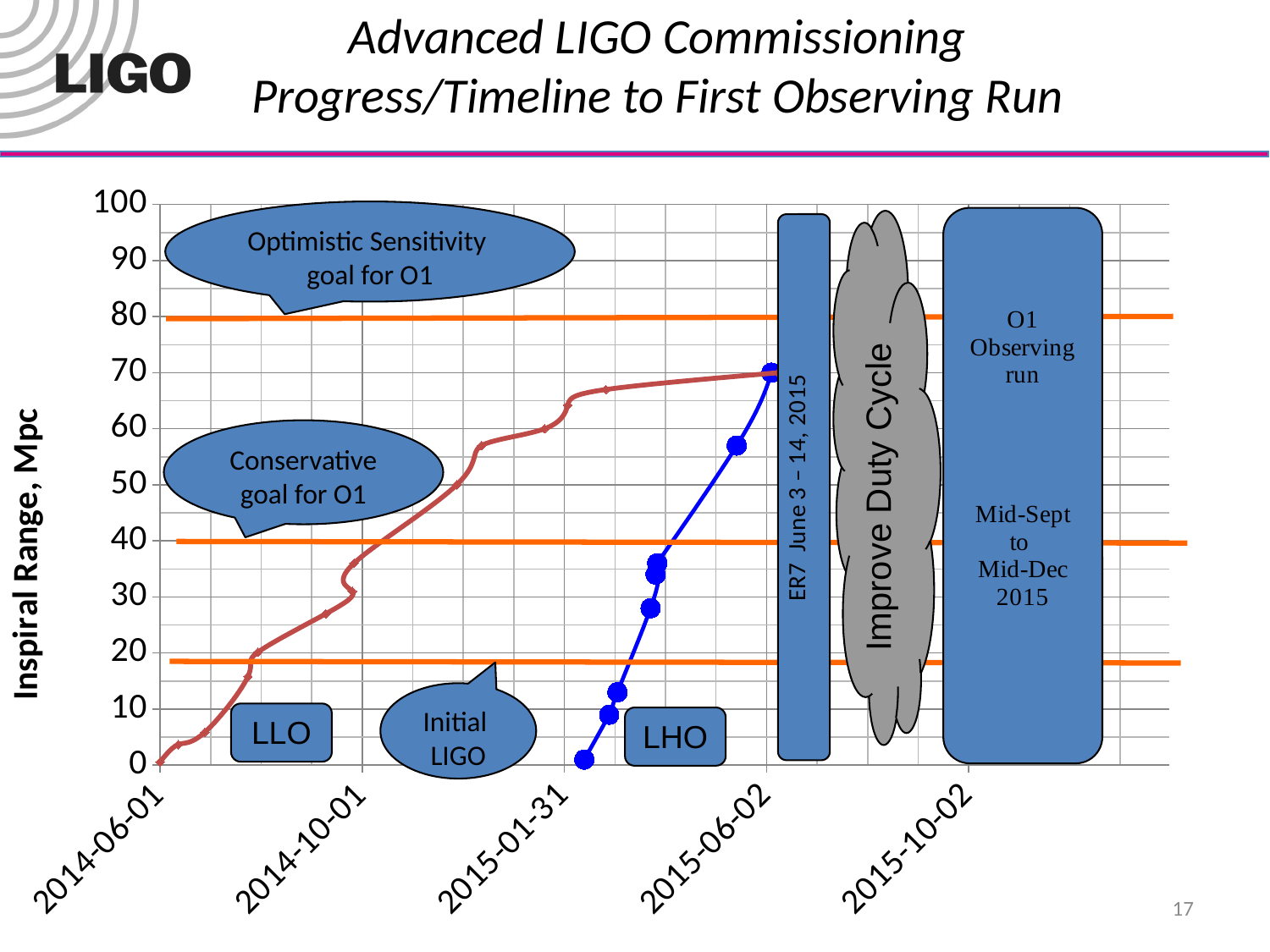
What is the label of the vertical axis? Inspiral Range, Mpc Is the Optimistic Sensitivity goal for O1 line greater or less than 60 Mpc? greater Is the Conservative goal for O1 line greater or less than 30 Mpc? greater How many date labels are shown along the horizontal axis? 5 What dates are given for ER7 on the chart? June 3 – 14, 2015 Does the LLO inspiral range rise or fall from 2014-06-01 to 2015-06-02? rises Which series starts earlier in time, LLO or LHO? LLO Is the LLO value at 2014-10-01 greater or less than 20? greater What kind of chart is shown on the slide? line chart What is the maximum value shown on the vertical axis? 100